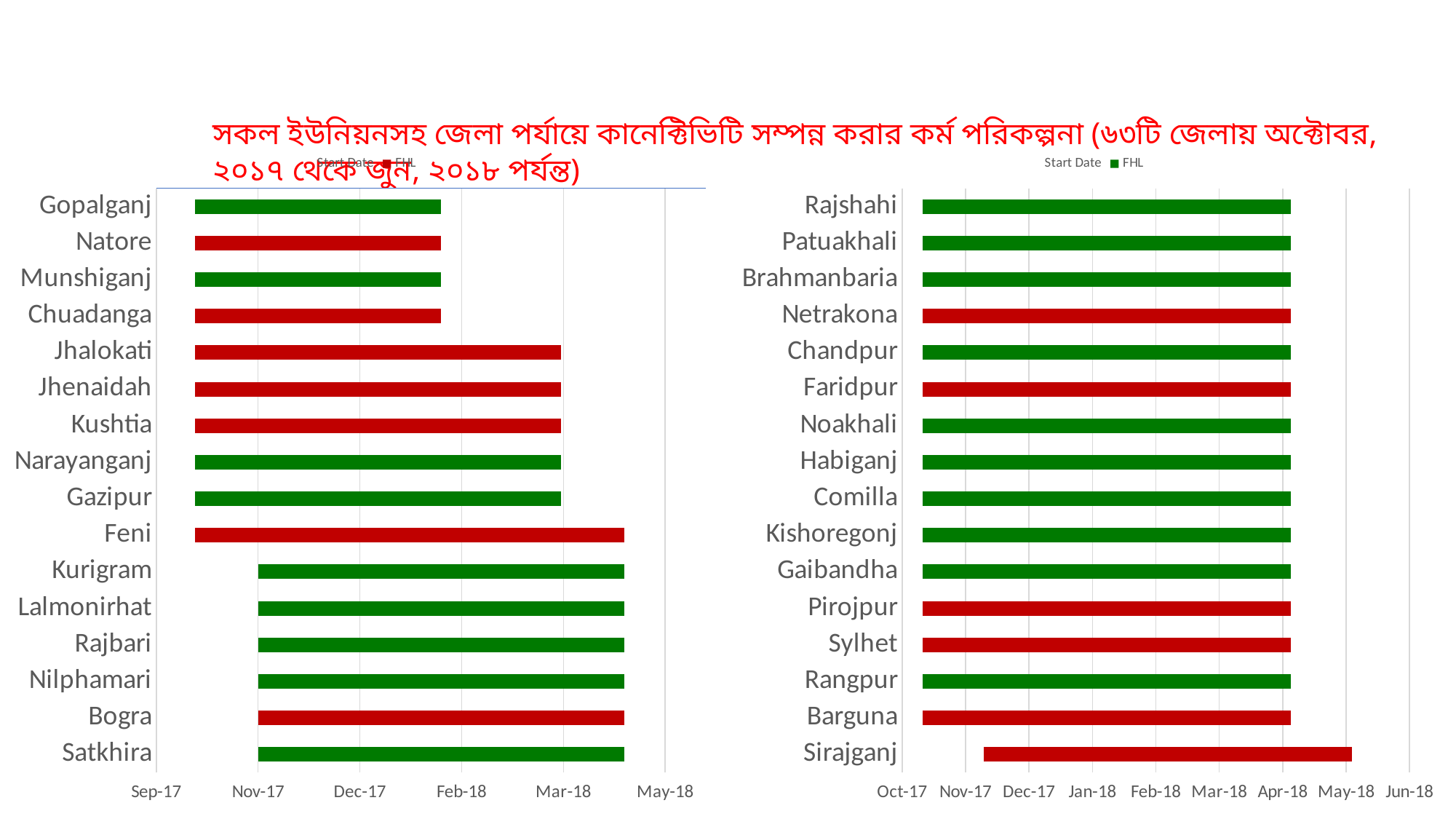
On the right chart, which district's bar starts the latest? Sirajganj On the left chart, does the bar for Jhalokati end before or after Feb-18? after What kind of chart is shown on the left side of the slide? bar chart On the left chart, which district has the longest bar? Feni On the left chart, which bar is longer, Feni or Natore? Feni On the right chart, does the bar for Sirajganj end before or after Apr-18? after On the left chart, does the bar for Gopalganj end before or after Feb-18? before How many districts are listed on the right chart (Rajshahi to Sirajganj)? 16 How many districts are listed on the left chart (Gopalganj to Satkhira)? 16 How many entries does the legend of the right chart list? 2 On the right chart, what colour is the bar for Netrakona? red